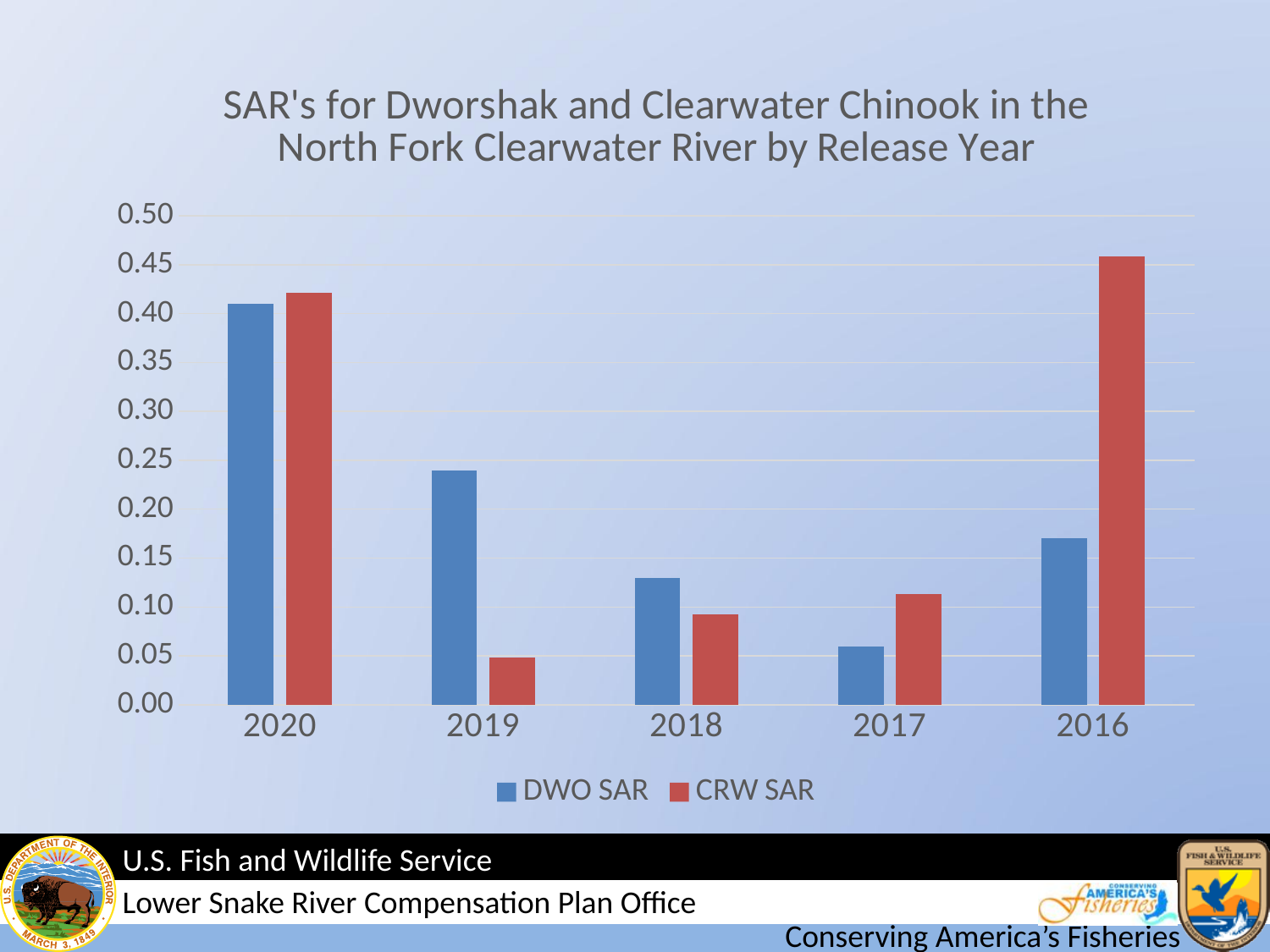
Which release year has the lowest DWO SAR value? 2017 How many series does the legend list? 2 For release year 2016, which is larger, DWO SAR or CRW SAR? CRW SAR Which release year has the highest CRW SAR value? 2016 Which colour represents the CRW SAR series in the legend? red Which release year has the highest DWO SAR value? 2020 Is the CRW SAR value for 2016 greater or less than 0.40? greater What kind of chart is shown on the slide? bar chart For release year 2019, which is larger, DWO SAR or CRW SAR? DWO SAR How many release years are shown on the x axis? 5 Is the DWO SAR value for 2019 greater or less than 0.30? less Which release year has the lowest CRW SAR value? 2019